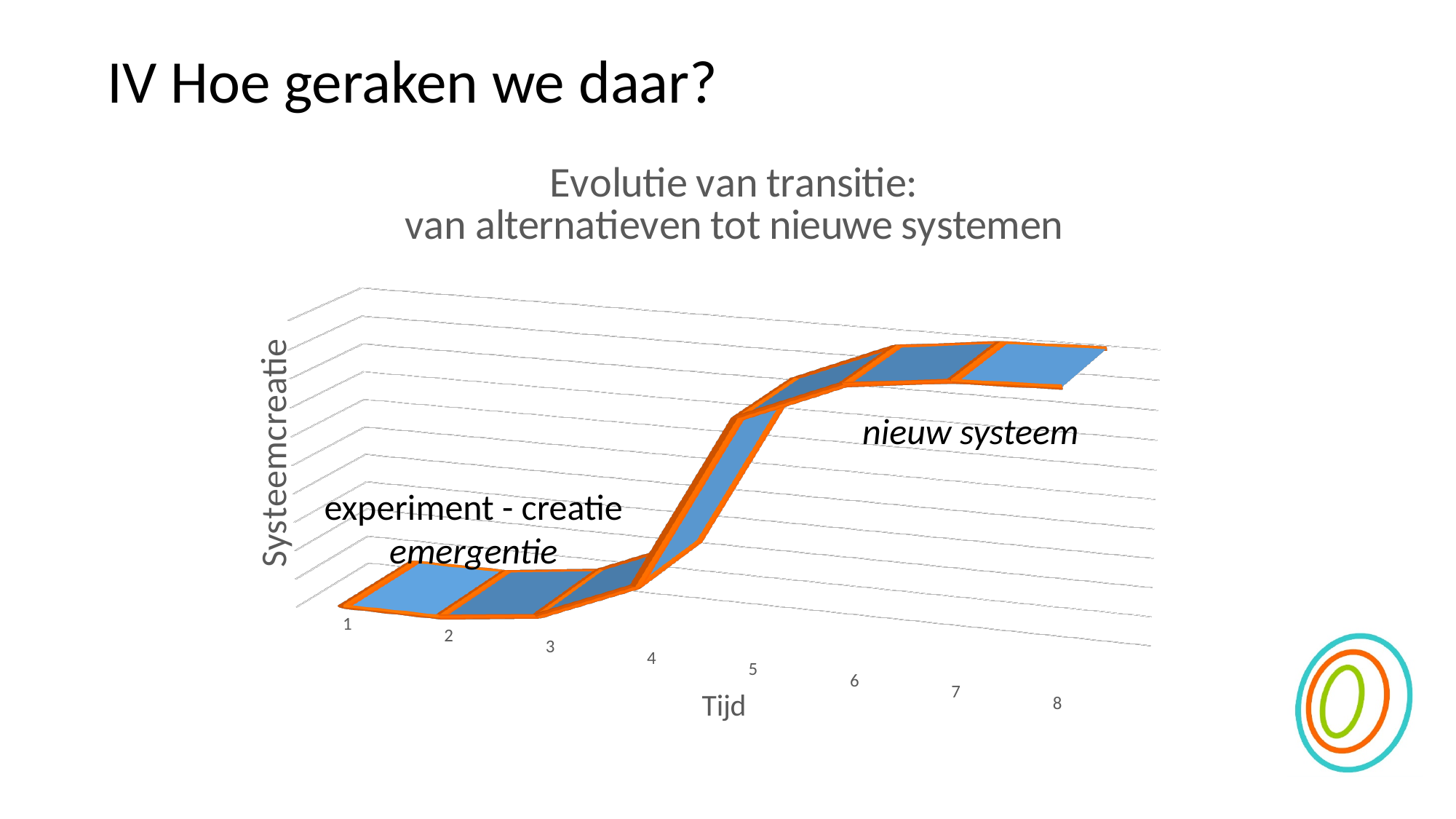
Which is larger, the value at point 4 or the value at point 5? point 5 Do the values rise or fall as you move from 1 to 8 along the x axis? rise What is the label of the x axis? Tijd Which is larger, the value at point 2 or the value at point 7? point 7 Between which two x-axis points does the steepest rise in the line occur? between 4 and 5 What is the title of the chart? Evolutie van transitie: van alternatieven tot nieuwe systemen Which is larger, the value at point 1 or the value at point 8? point 8 How many points are plotted along the x axis of the chart? 8 What kind of chart is shown on the slide? line chart